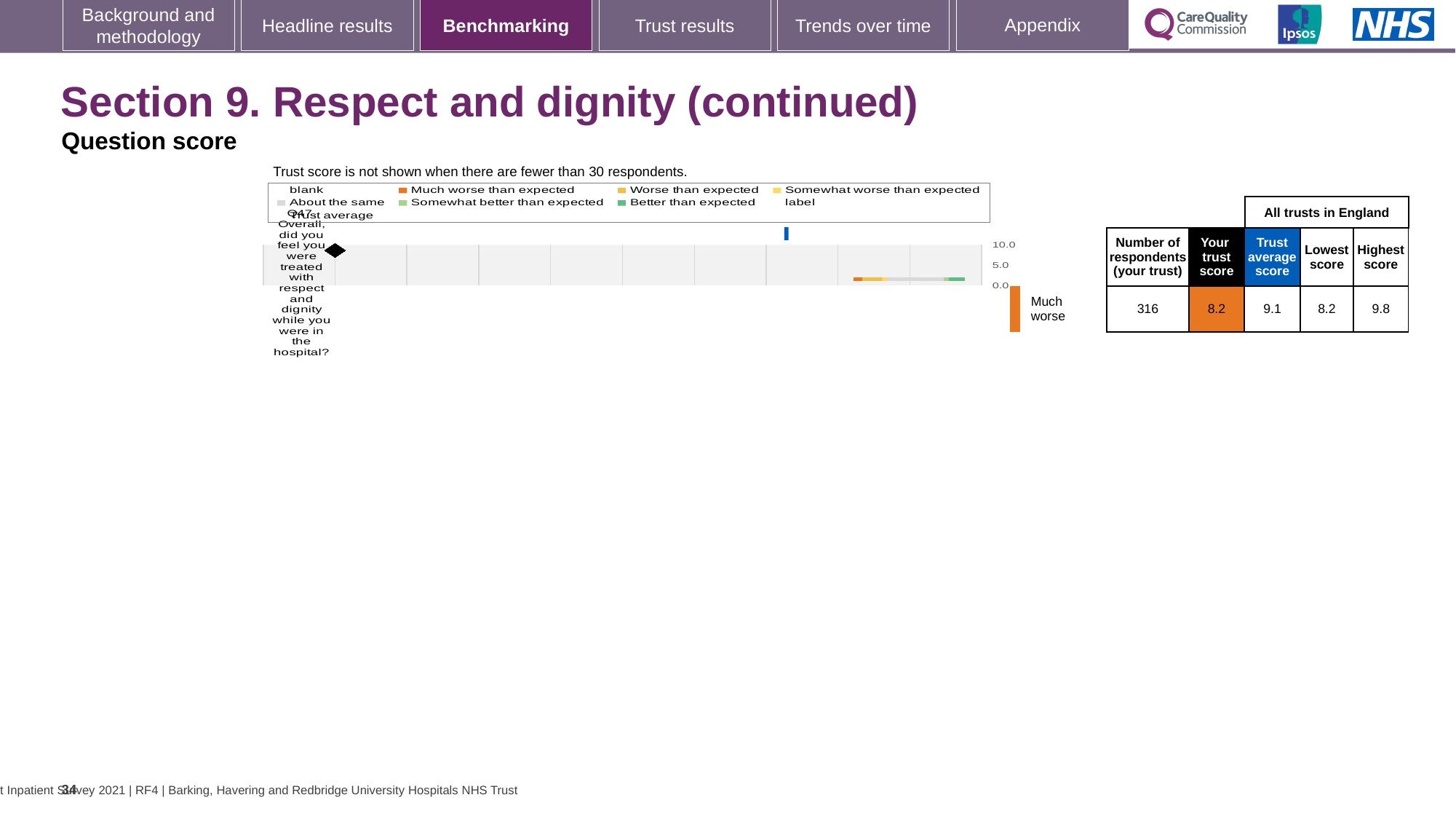
In the table next to the chart, what is the difference between the highest score and the lowest score? 1.6 In the table next to the chart, what is your trust score for Q47? 8.2 In the table next to the chart, what is the trust average score for all trusts in England? 9.1 What kind of chart is shown on the slide? bar chart What is the highest tick value shown on the chart's score axis? 10.0 In the table next to the chart, what is the highest score among all trusts in England? 9.8 In the table next to the chart, what is the number of respondents for your trust? 316 How many questions (categories) are plotted on the chart? 1 Which question number is plotted on the chart? Q47 In the table next to the chart, which is larger: your trust score or the trust average score? Trust average score